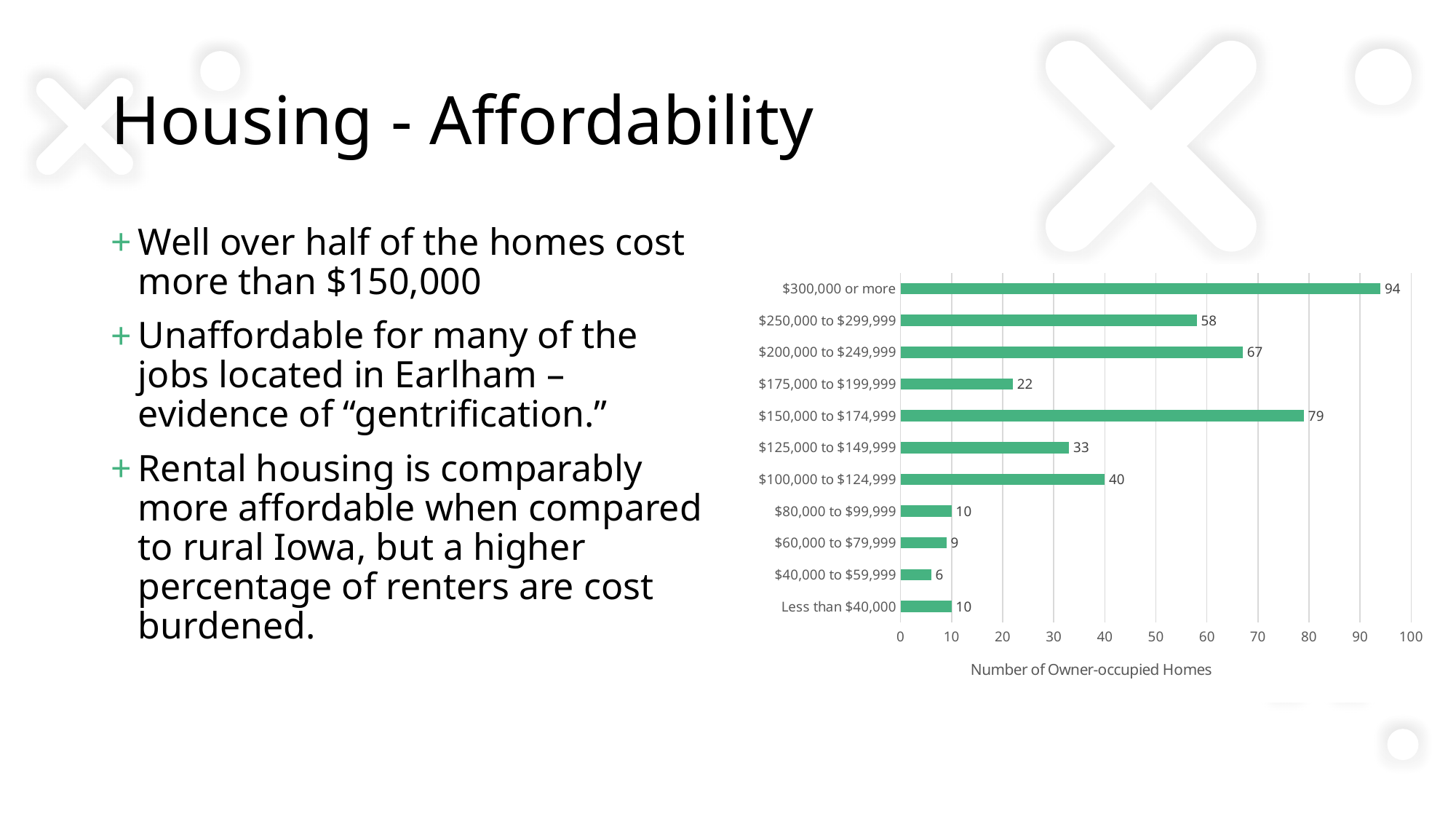
Is the value for $175,000 to $199,999 greater or less than 30? less How many owner-occupied homes are in the $300,000 or more category? 94 What is the label of the horizontal axis of the chart? Number of Owner-occupied Homes What kind of chart is shown on the slide? bar chart How many price categories are shown in the chart? 11 Which price category has the lowest number of owner-occupied homes? $40,000 to $59,999 What is the value for the $150,000 to $174,999 category? 79 How many owner-occupied homes are valued at $40,000 to $59,999? 6 Which price category has the highest number of owner-occupied homes? $300,000 or more What is the difference between the $200,000 to $249,999 and $250,000 to $299,999 categories? 9 Which has more owner-occupied homes: $100,000 to $124,999 or $125,000 to $149,999? $100,000 to $124,999 What is the total number of homes in the $60,000 to $79,999 and $80,000 to $99,999 categories combined? 19